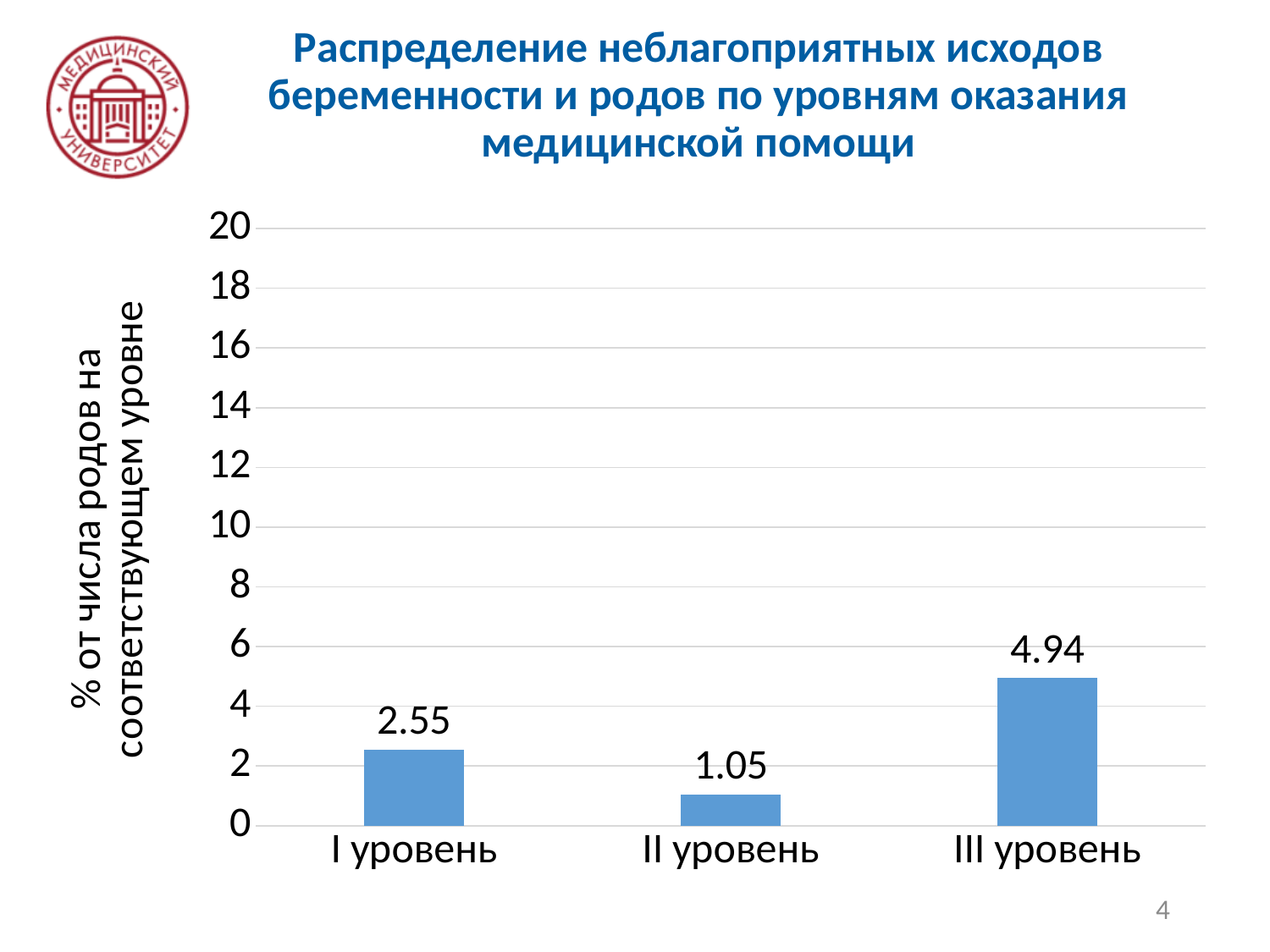
How many categories are shown on the x axis? 3 Is the value for III уровень greater or less than 4? greater Which category has the lowest value? II уровень What is the value for III уровень? 4.94 Which is larger, the value for I уровень or the value for II уровень? I уровень Which category has the highest value? III уровень What is the label of the vertical axis? % от числа родов на соответствующем уровне What is the difference between the values for III уровень and I уровень? 2.39 What is the difference between the values for I уровень and II уровень? 1.5 What is the value for II уровень? 1.05 What is the value for I уровень? 2.55 What kind of chart is shown on the slide? bar chart